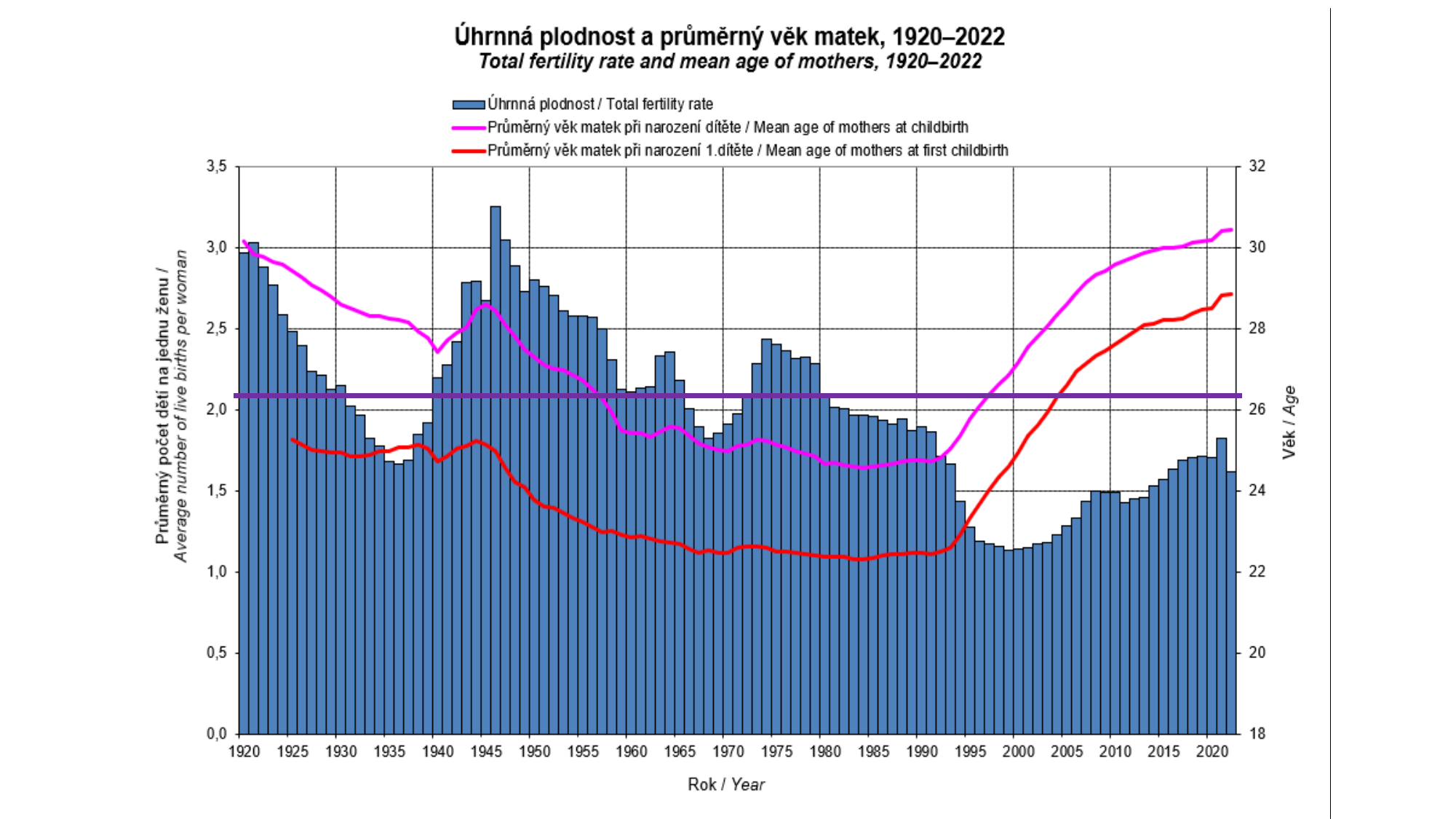
In which year is the total fertility rate highest? 1946 Is the total fertility rate in 1999 greater or less than 1,5? less What kind of chart is shown on the slide? A combined bar and line chart Does the total fertility rate rise or fall between 1920 and 1935? fall Is the total fertility rate in 1946 greater or less than 3,0? greater What is the label of the x axis? Rok / Year Is the total fertility rate in 1935 greater or less than 2,0? less Does the mean age of mothers at first childbirth rise or fall between 1995 and 2022? rise Which is larger, the total fertility rate in 1946 or in 1974? 1946 How many series does the legend list? 3